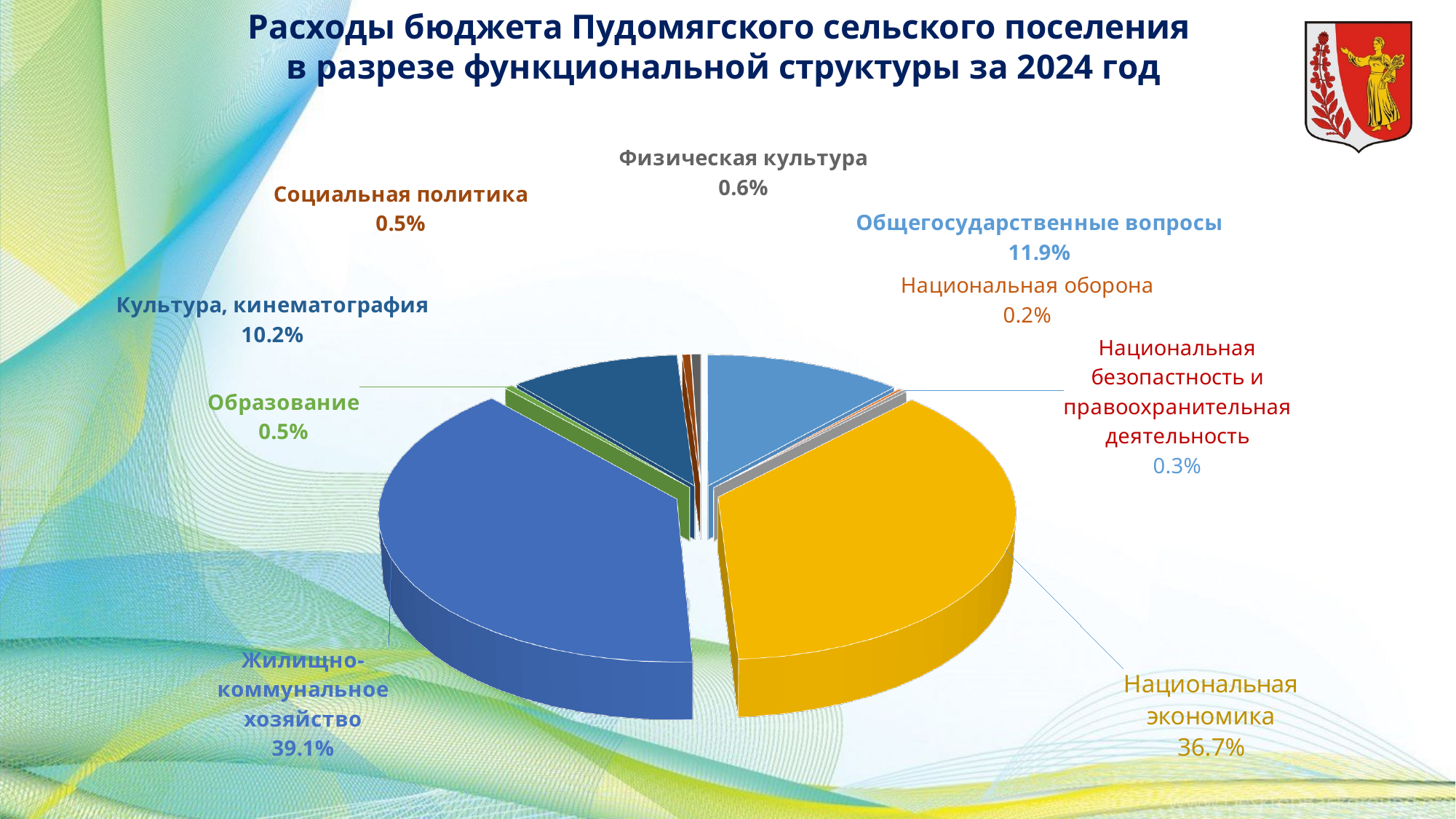
What is the difference in percentage points between Жилищно-коммунальное хозяйство and Национальная экономика? 2.4 What type of chart is shown on the slide? Pie chart What share is shown for Культура, кинематография? 10.2% Which is larger: the share for Общегосударственные вопросы or for Культура, кинематография? Общегосударственные вопросы What share is shown for Национальная оборона? 0.2% What share of the budget expenses goes to Национальная экономика? 36.7% How many categories are shown in the pie chart? 9 What year does the chart title refer to? 2024 What share of the budget expenses goes to Жилищно-коммунальное хозяйство? 39.1% What share is shown for Общегосударственные вопросы? 11.9% Which category has the largest share of expenses? Жилищно-коммунальное хозяйство Which category has the smallest share of expenses? Национальная оборона